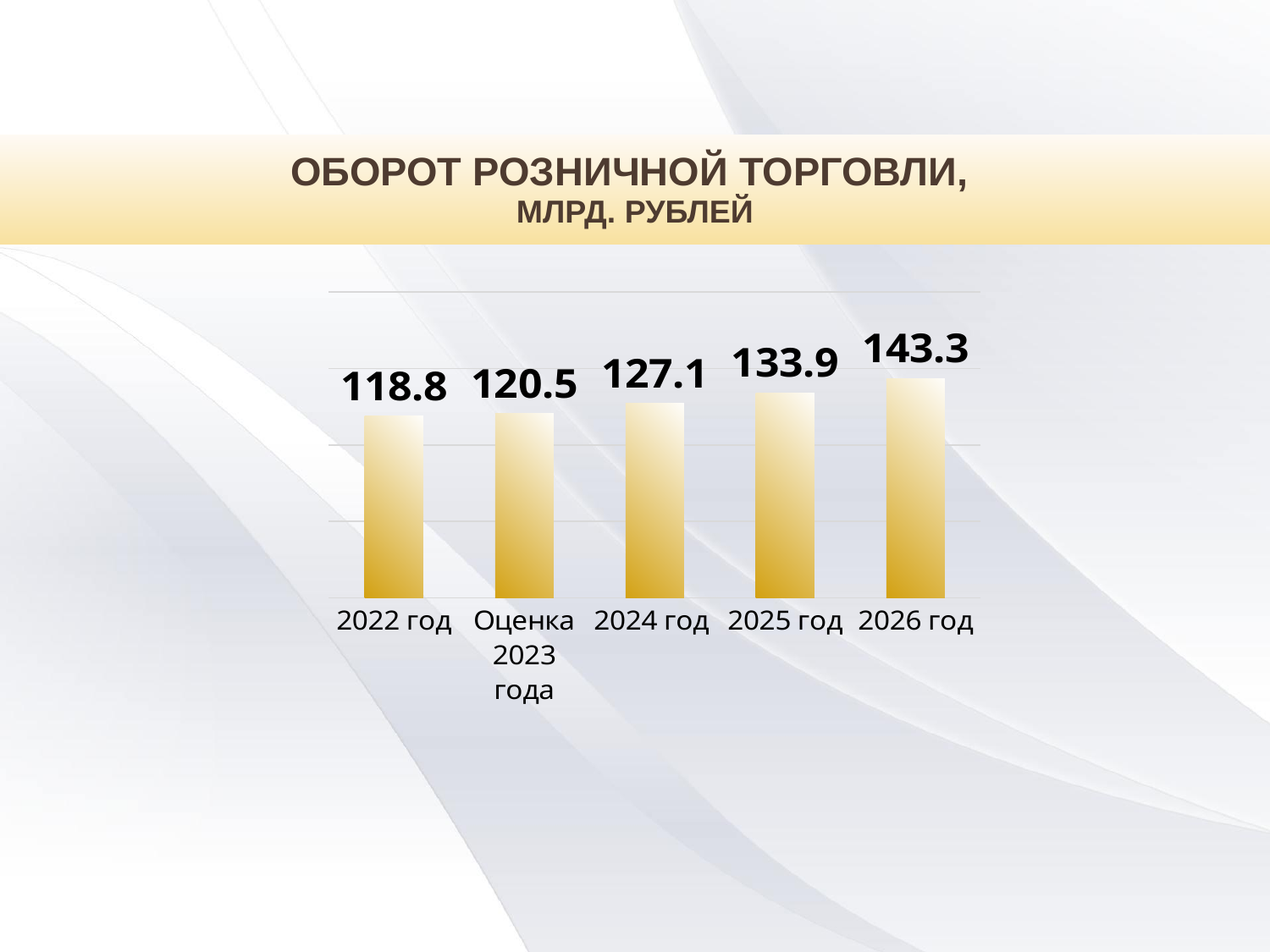
What kind of chart is shown on the slide? bar chart Which category has the lowest value? 2022 год What is the difference between the values for 2025 год and 2024 год? 6.8 What is the value for Оценка 2023 года? 120.5 What is the difference between the values for 2026 год and 2022 год? 24.5 How many categories are shown on the chart? 5 Do the values rise or fall from 2022 год to 2026 год? rise What is the value for 2026 год? 143.3 What is the value for 2024 год? 127.1 Which is larger, the value for 2025 год or the value for 2024 год? 2025 год What is the value for 2022 год? 118.8 Which category has the highest value? 2026 год